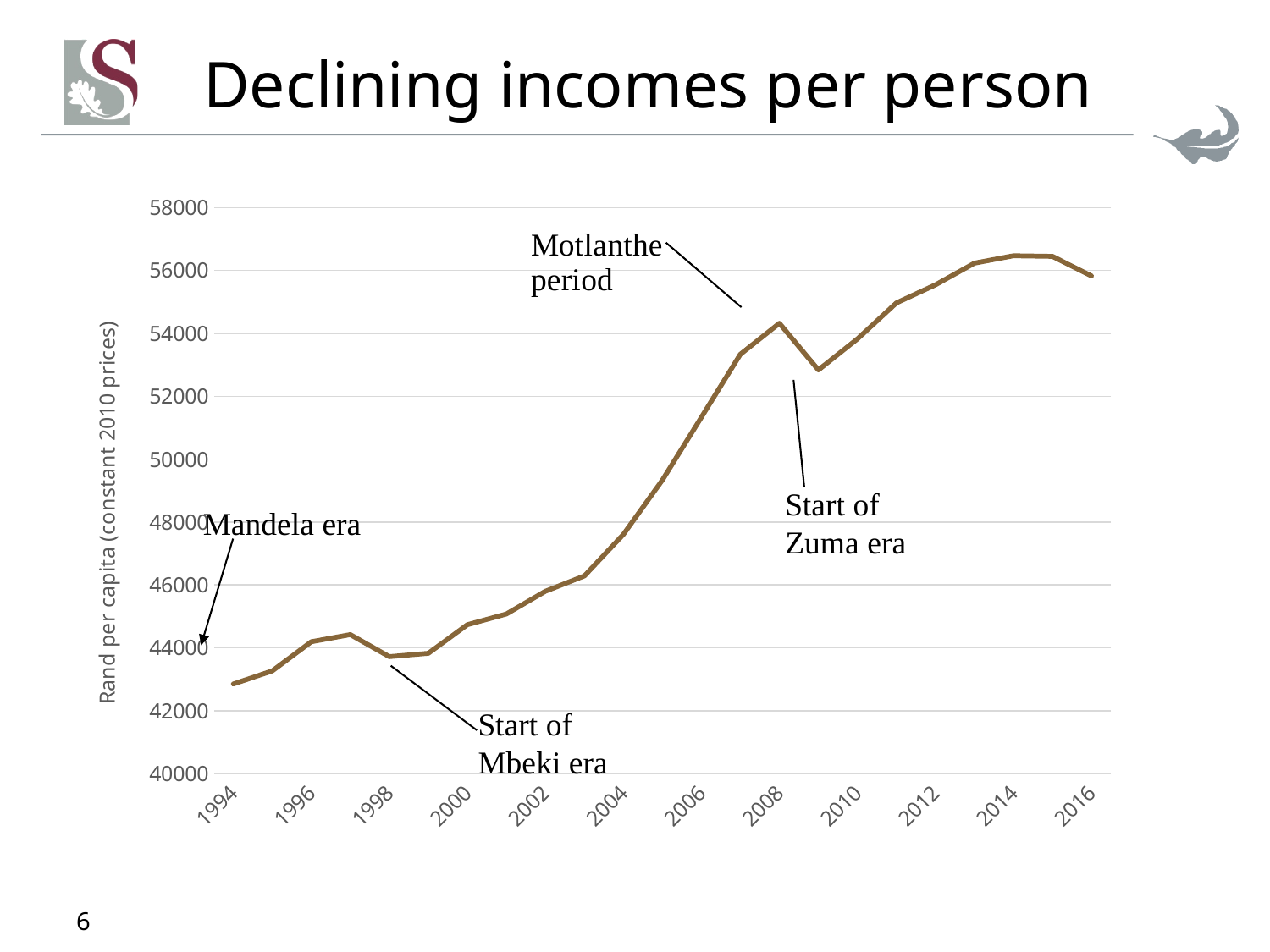
Is the value for 2016 greater or less than 54000? greater Is the value for 1994 greater or less than 44000? less Does the line rise or fall between 2015 and 2016? fall What kind of chart is shown on the slide? line chart Which is larger, the value for 2008 or the value for 2009? 2008 Is the value for 2009 greater or less than 54000? less What is the label on the vertical axis of the chart? Rand per capita (constant 2010 prices) How many year labels are shown on the x axis? 12 Which year has the lowest value on the chart? 1994 What is the title of the slide's chart? Declining incomes per person